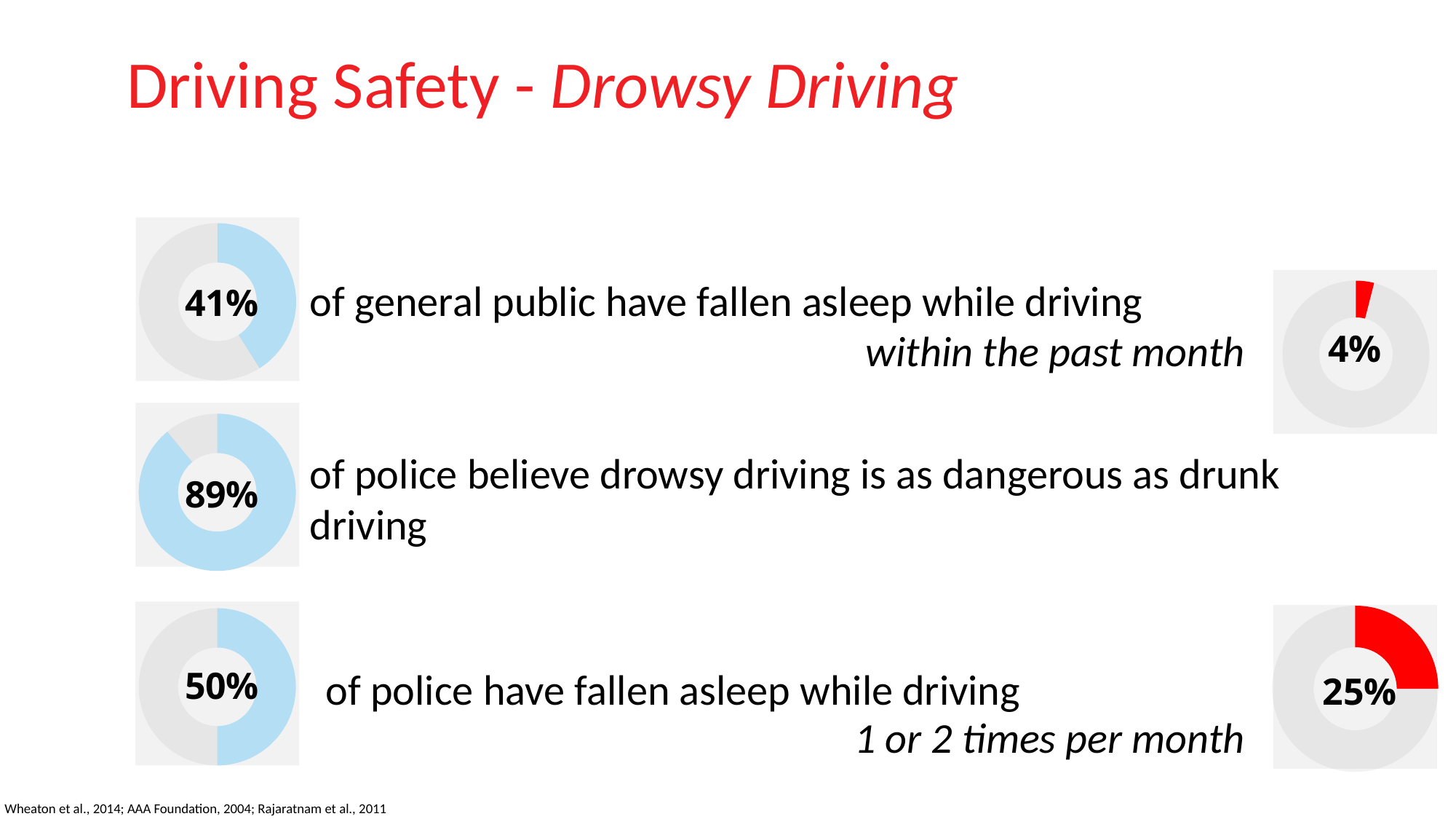
Which of the donut charts on the slide shows the lowest percentage? 4% (general public fallen asleep while driving within the past month) What value is shown in the bottom-right donut chart for police falling asleep while driving 1 or 2 times per month? 25% What value is shown in the top-right donut chart for the general public falling asleep while driving within the past month? 4% What kind of chart is used to display the percentages on this slide? Donut (pie) chart What percentage of police have fallen asleep while driving, according to the bottom-left donut chart? 50% How many donut charts are shown on the slide? 5 Which of the donut charts on the slide shows the highest percentage? 89% (police believe drowsy driving is as dangerous as drunk driving) What colour is the filled segment in the two donut charts on the right side of the slide? Red What is the difference between the percentage of police who have fallen asleep while driving (bottom-left chart) and the percentage of the general public who have (top-left chart)? 9% What percentage of the general public have fallen asleep while driving, according to the top-left donut chart? 41% Which is larger: the bottom-right chart value for police falling asleep 1 or 2 times per month, or the top-right chart value for the general public within the past month? Police, 25% What percentage of police believe drowsy driving is as dangerous as drunk driving, according to the middle-left donut chart? 89%